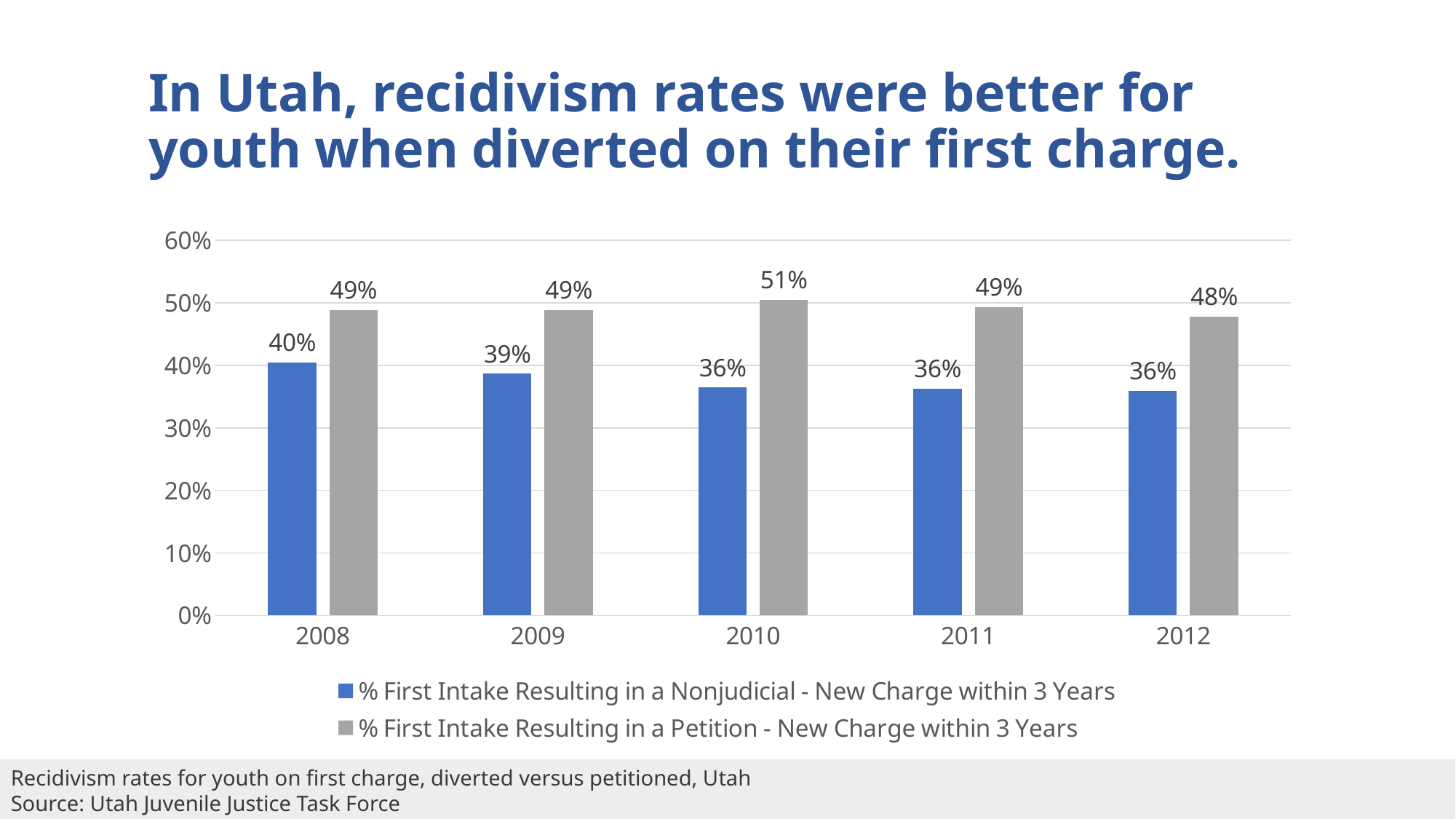
What is the value for the Nonjudicial series in 2012? 36% What kind of chart is shown on the slide? Bar chart What is the difference between the Petition and Nonjudicial values in 2010? 15% What is the value for the Nonjudicial series in 2008? 40% In which year is the Nonjudicial series highest? 2008 How many years are shown on the x axis? 5 In which year is the Petition series lowest? 2012 What is the value for the Petition series in 2010? 51% What is the difference between the Petition and Nonjudicial values in 2008? 9% In 2011, which series has the larger value, Nonjudicial or Petition? Petition In which year is the Petition series highest? 2010 How many series does the legend list? 2